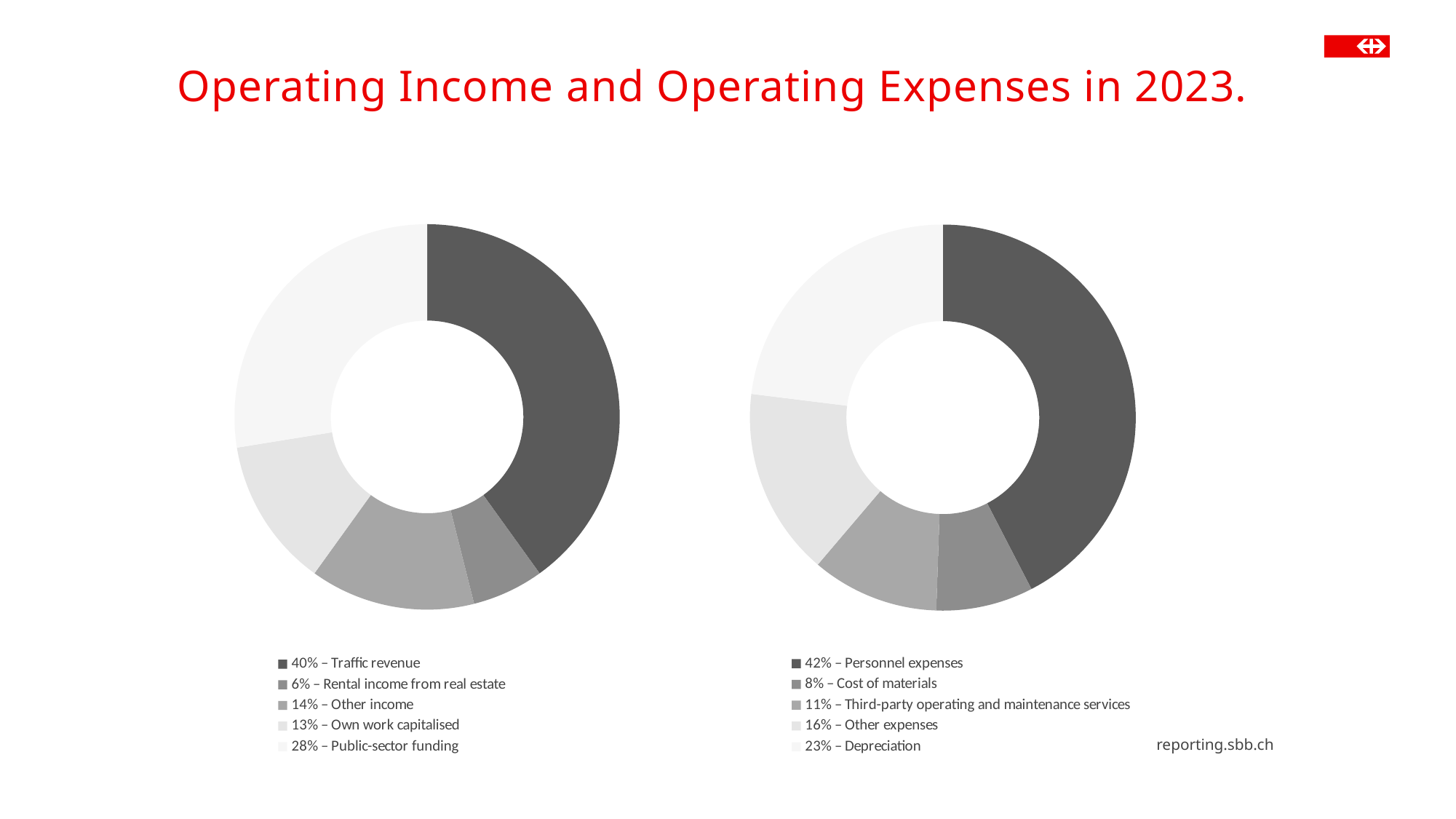
What is the title of the slide? Operating Income and Operating Expenses in 2023. What kind of chart is the left chart (operating income)? Pie (doughnut) chart How many categories does the right chart (operating expenses) show? 5 In the right chart (operating expenses), which is larger: Other expenses or Third-party operating and maintenance services? Other expenses In the left chart (operating income), which category has the smallest share? Rental income from real estate In the right chart (operating expenses), what share is Depreciation? 23% In the left chart (operating income), what is the difference between the shares of Public-sector funding and Other income? 14% In the right chart (operating expenses), which category has the largest share? Personnel expenses In the left chart (operating income), what share is Traffic revenue? 40% How many categories does the left chart (operating income) show? 5 In the right chart (operating expenses), what share is Cost of materials? 8% In the left chart (operating income), what is the combined share of Own work capitalised and Public-sector funding? 41%